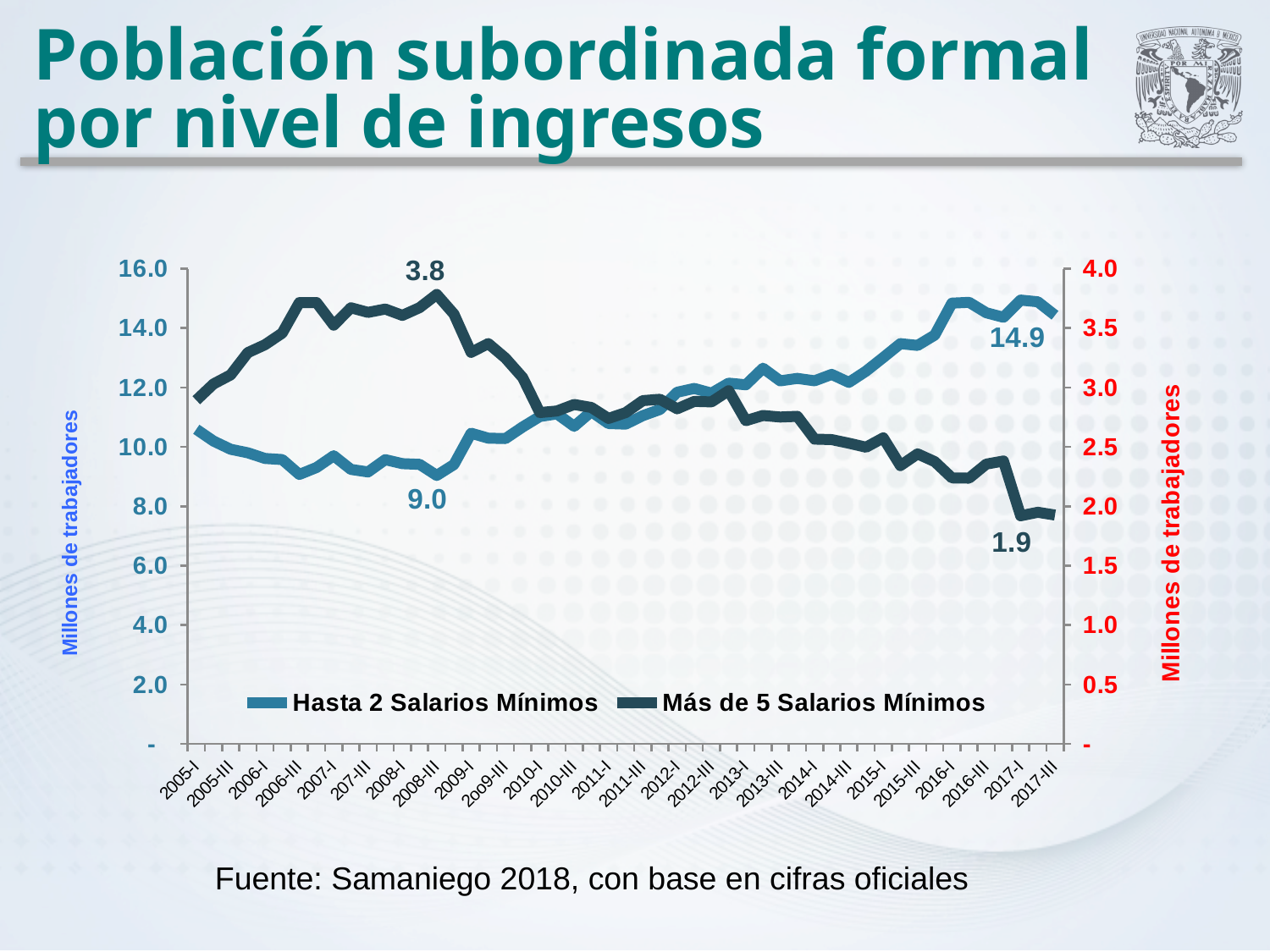
What is the labelled value of the 'Hasta 2 Salarios Mínimos' series near the end of the period (2017)? 14.9 What is the labelled low value of the 'Hasta 2 Salarios Mínimos' series around 2008-III? 9.0 What is the label on the left vertical axis? Millones de trabajadores What kind of chart is shown on the slide? line chart By how much did the 'Hasta 2 Salarios Mínimos' series rise from its labelled low of 9.0 to its labelled value of 14.9? 5.9 What is the labelled value of the 'Más de 5 Salarios Mínimos' series at the end of the period (2017-III)? 1.9 Is the value for 'Más de 5 Salarios Mínimos' at 2017-III greater or less than 2.5? less How many series does the legend list? 2 Is the value for 'Hasta 2 Salarios Mínimos' at 2016-I greater or less than 14.0? greater Does the 'Más de 5 Salarios Mínimos' series rise or fall overall from 2005-I to 2017-III? fall What is the labelled peak value of the 'Más de 5 Salarios Mínimos' series around 2008-III? 3.8 What is the difference between the labelled peak (3.8) and the labelled final value (1.9) of the 'Más de 5 Salarios Mínimos' series? 1.9